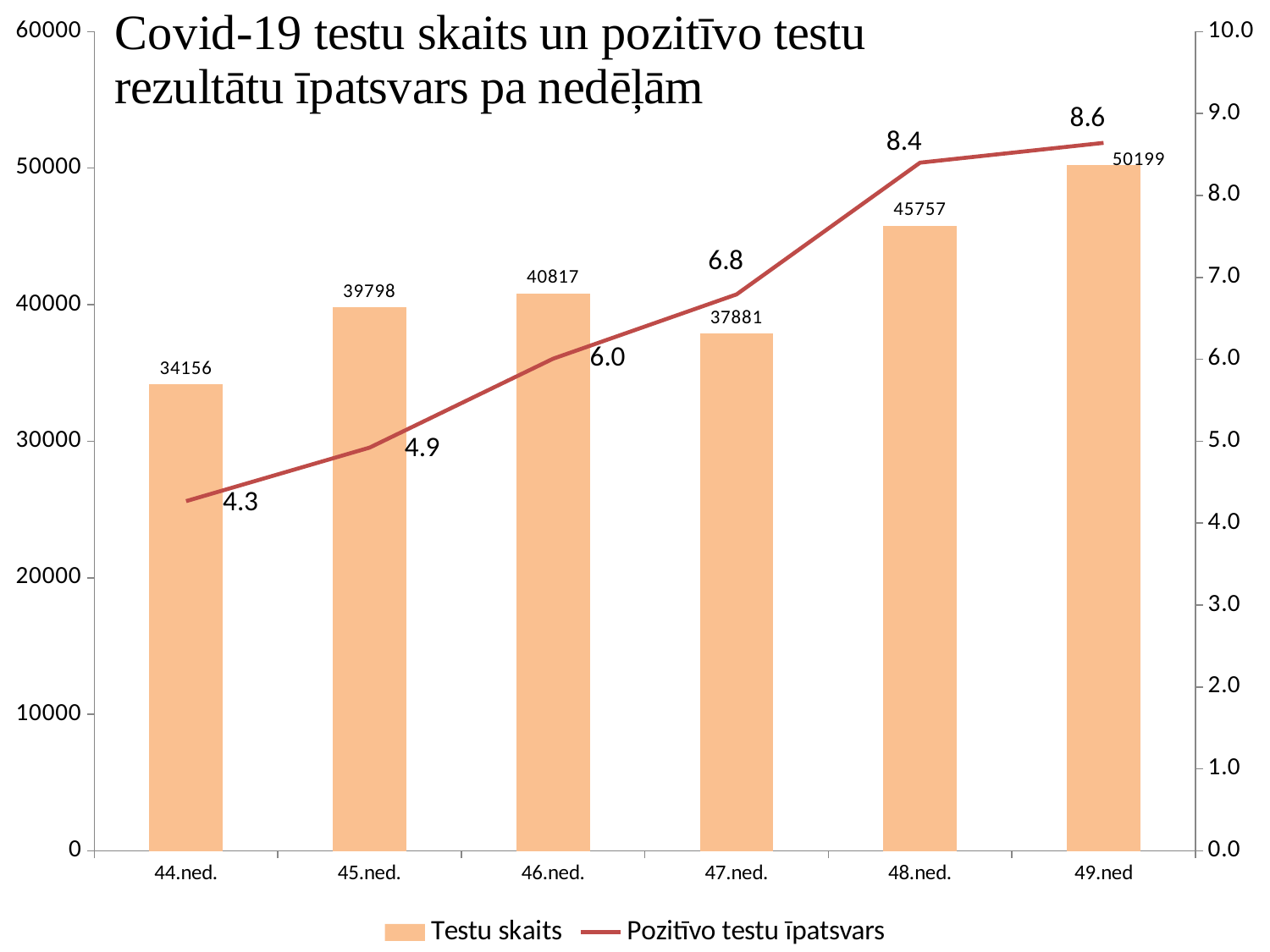
Which week has the lowest Pozitīvo testu īpatsvars? 44.ned. What is the value of Testu skaits for 44.ned.? 34156 How many series does the legend list? 2 What is the difference in Pozitīvo testu īpatsvars between 49.ned and 44.ned.? 4.3 Which week has the highest Testu skaits? 49.ned What is the title of the chart? Covid-19 testu skaits un pozitīvo testu rezultātu īpatsvars pa nedēļām What is the difference in Testu skaits between 48.ned. and 47.ned.? 7876 Which is larger, Testu skaits for 45.ned. or for 46.ned.? 46.ned. What is the value of Testu skaits for 49.ned? 50199 What is the value of Pozitīvo testu īpatsvars for 47.ned.? 6.8 How many weeks are shown on the x axis? 6 Does Pozitīvo testu īpatsvars rise or fall from 44.ned. to 49.ned? rise